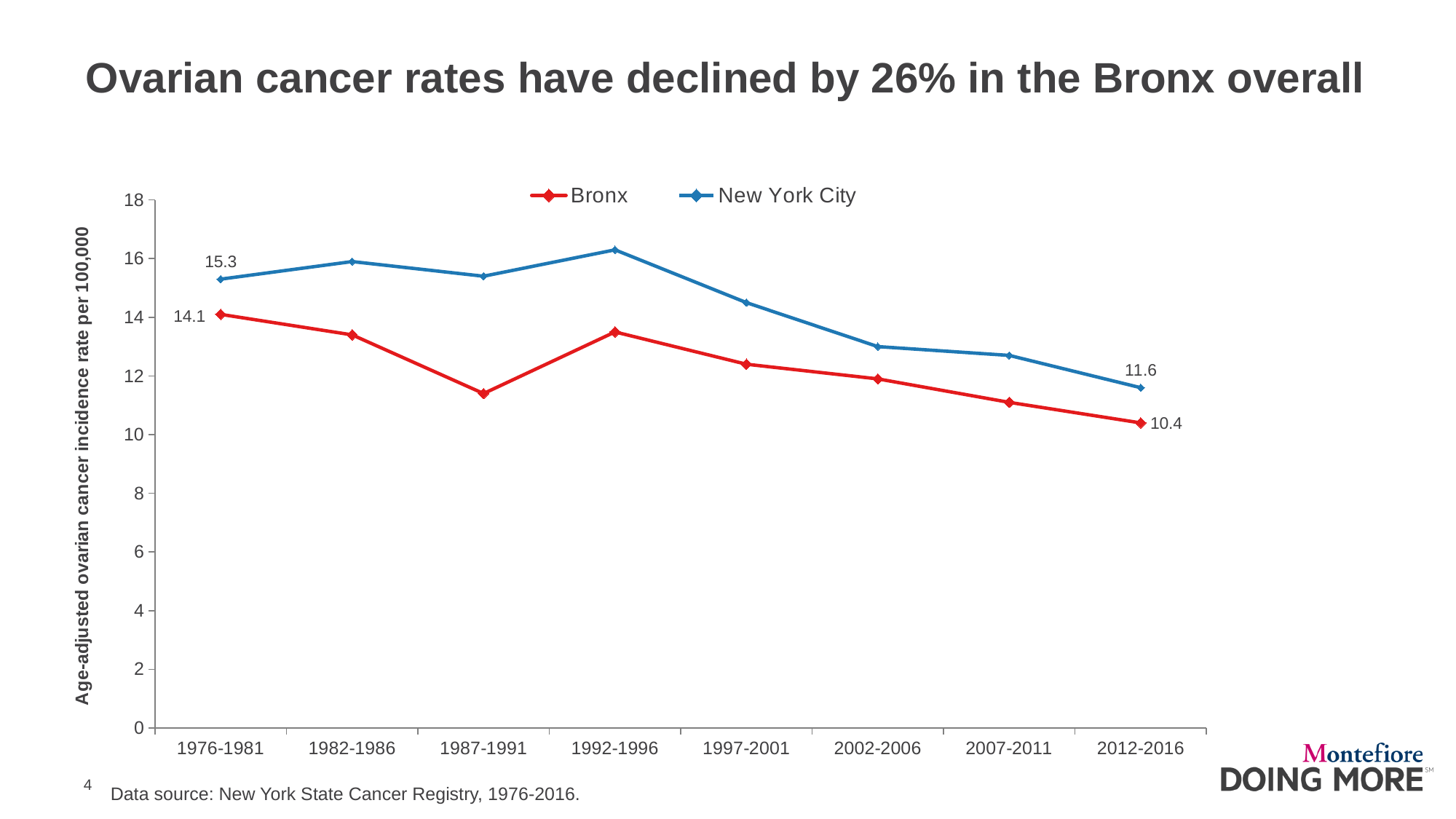
What kind of chart is shown on the slide? Line chart Which series has the higher rate in 1997-2001, Bronx or New York City? New York City What is the New York City age-adjusted ovarian cancer incidence rate for 2012-2016? 11.6 Is the New York City value for 1992-1996 greater or less than 16? greater What is the Bronx rate for 2012-2016? 10.4 How many series does the legend list? 2 What is the New York City rate for 1976-1981? 15.3 By how much did the Bronx rate fall between 1976-1981 and 2012-2016? 3.7 How many time periods are shown on the x axis? 8 What is the Bronx age-adjusted ovarian cancer incidence rate for 1976-1981? 14.1 Is the Bronx value for 1987-1991 greater or less than 12? less What is the difference between the New York City and Bronx rates in 2012-2016? 1.2